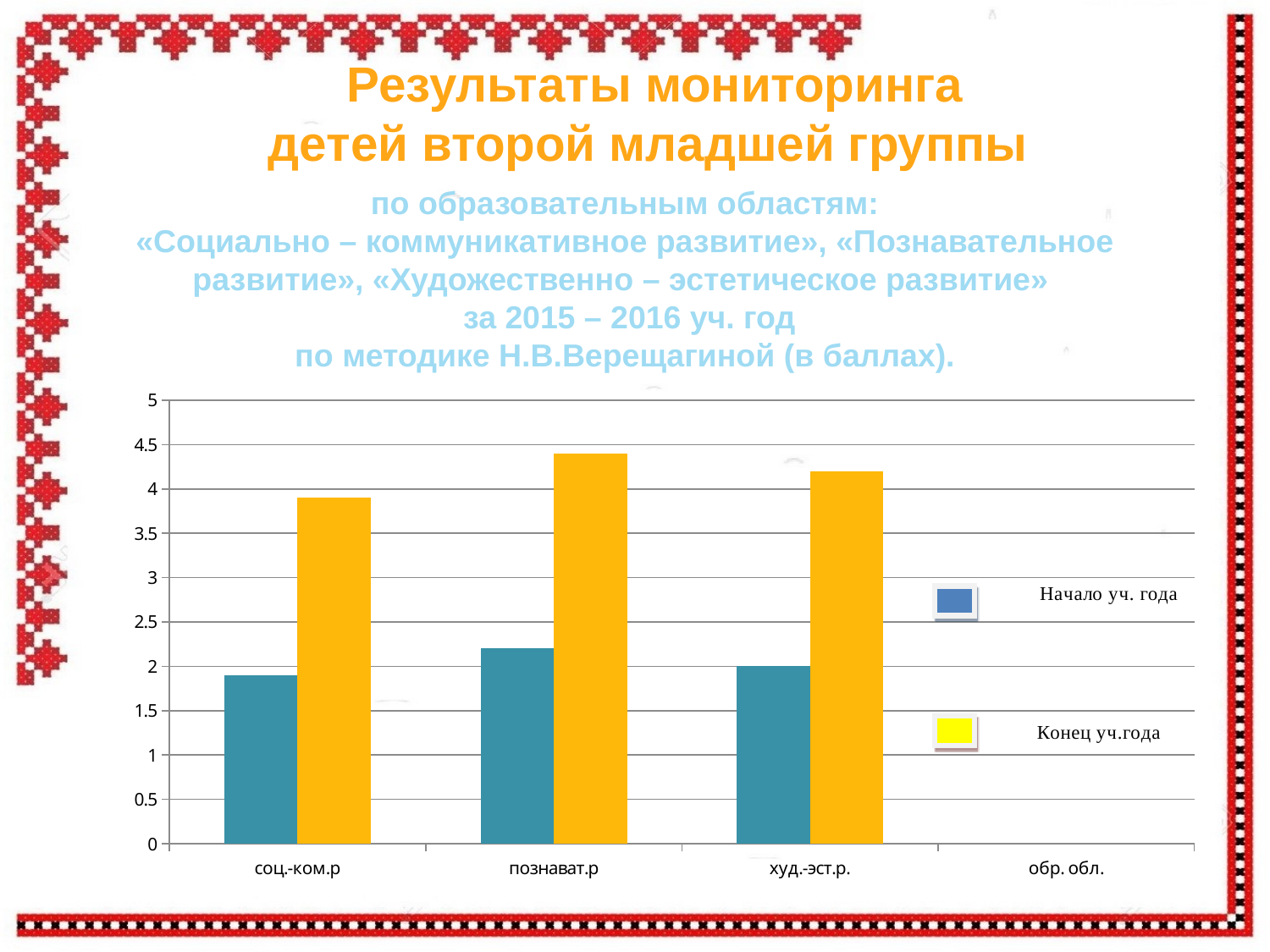
Is the Начало уч. года value for познават.р greater or less than 2? greater How many series does the chart legend list? 2 Is the Конец уч.года value for познават.р greater or less than 4? greater Which category has the lowest value for Конец уч.года? соц.-ком.р What kind of chart is shown on the slide? bar chart Which category has the highest value for Конец уч.года? познават.р Which category has the highest value for Начало уч. года? познават.р Is the Конец уч.года value for соц.-ком.р greater or less than 4? less What are the two series named in the chart legend? Начало уч. года and Конец уч.года For худ.-эст.р., which is larger: the Начало уч. года value or the Конец уч.года value? Конец уч.года How many categories on the x axis have bars plotted? 3